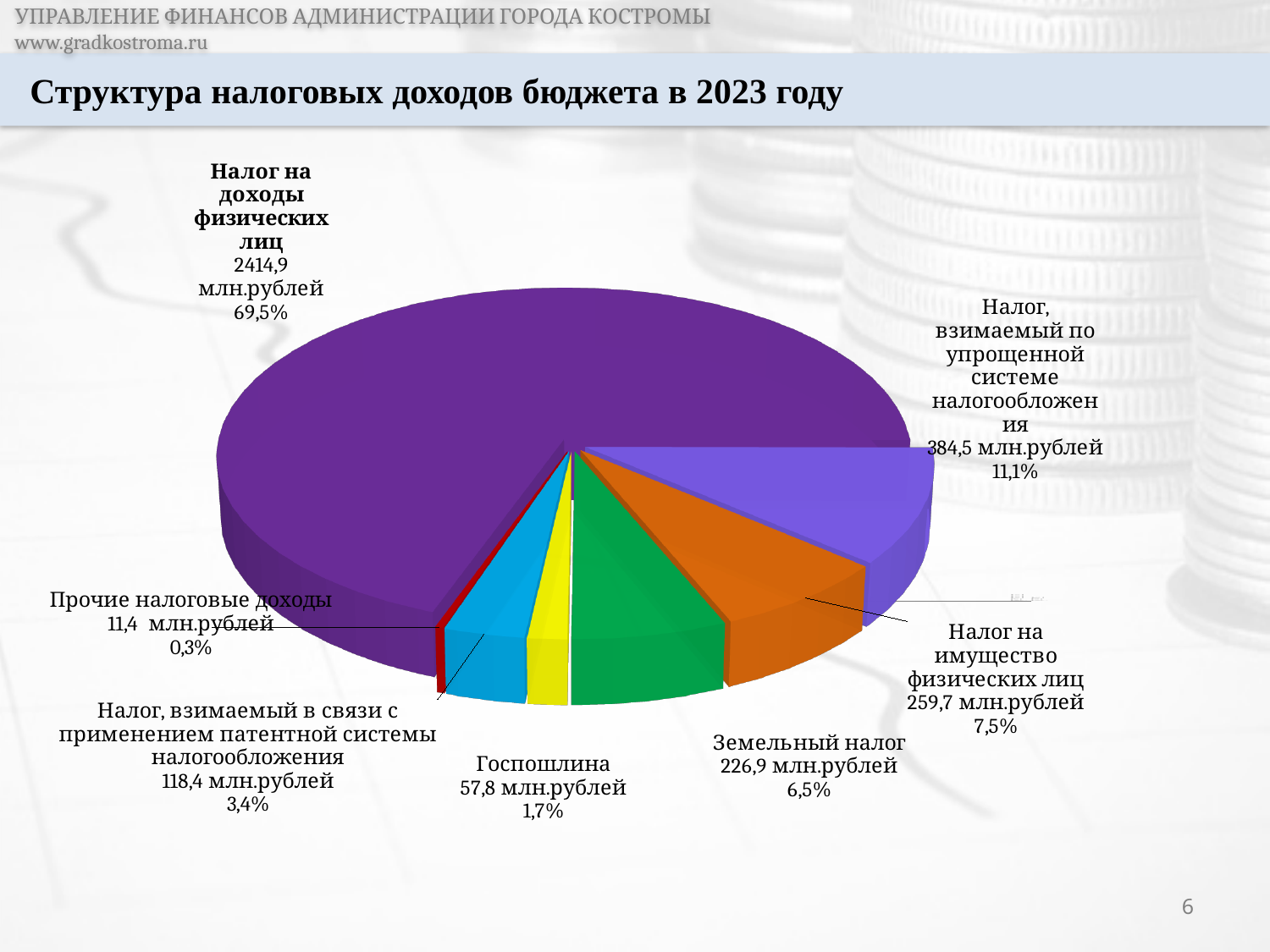
Какова сумма земельного налога? 226,9 млн.рублей Какой тип диаграммы показан на слайде? круговая диаграмма Какая категория имеет наименьшую долю в налоговых доходах? Прочие налоговые доходы Какова сумма налога на доходы физических лиц? 2414,9 млн.рублей На сколько млн.рублей налог на имущество физических лиц больше земельного налога? 32,8 млн.рублей Какая категория имеет наибольшую долю в налоговых доходах? Налог на доходы физических лиц Какую долю составляет госпошлина? 1,7% Какова сумма налога, взимаемого в связи с применением патентной системы налогообложения? 118,4 млн.рублей Какую долю составляет налог, взимаемый по упрощенной системе налогообложения? 11,1% Как называется диаграмма на слайде? Структура налоговых доходов бюджета в 2023 году Сколько категорий налоговых доходов подписано на диаграмме? 7 Что больше: налог на имущество физических лиц или земельный налог? Налог на имущество физических лиц